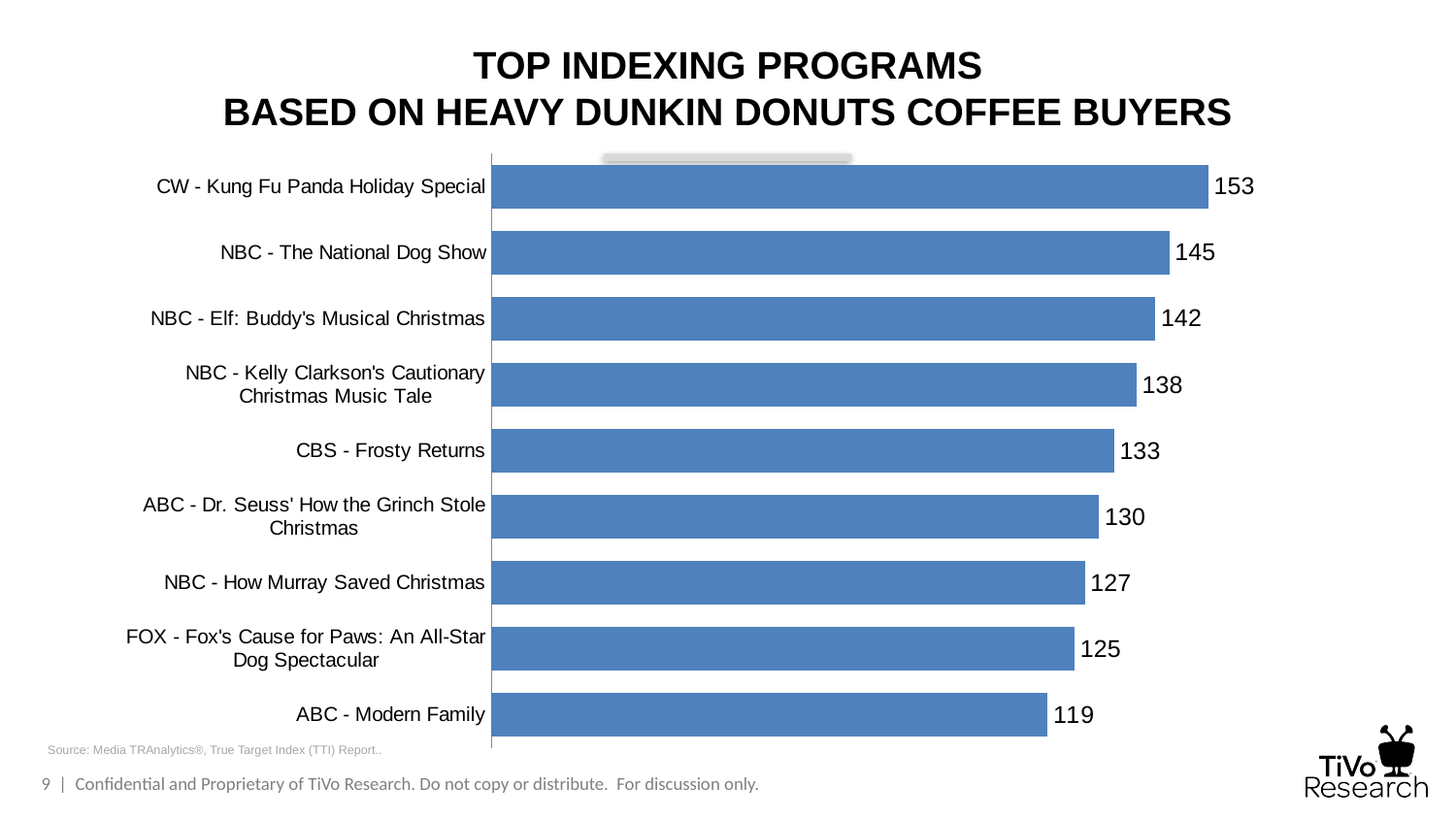
What is the index value for ABC - Modern Family? 119 How many programs are shown in the chart? 9 What is the title of the chart? Top Indexing Programs Based on Heavy Dunkin Donuts Coffee Buyers What type of chart is shown on the slide? Bar chart What is the difference between the index values of NBC - The National Dog Show and NBC - Elf: Buddy's Musical Christmas? 3 Which program has the highest index value? CW - Kung Fu Panda Holiday Special What is the index value for FOX - Fox's Cause for Paws: An All-Star Dog Spectacular? 125 Which program has the lowest index value? ABC - Modern Family Which has a higher index value, NBC - How Murray Saved Christmas or ABC - Dr. Seuss' How the Grinch Stole Christmas? ABC - Dr. Seuss' How the Grinch Stole Christmas What is the difference between the highest and lowest index values shown? 34 What is the index value for CW - Kung Fu Panda Holiday Special? 153 What is the index value for CBS - Frosty Returns? 133